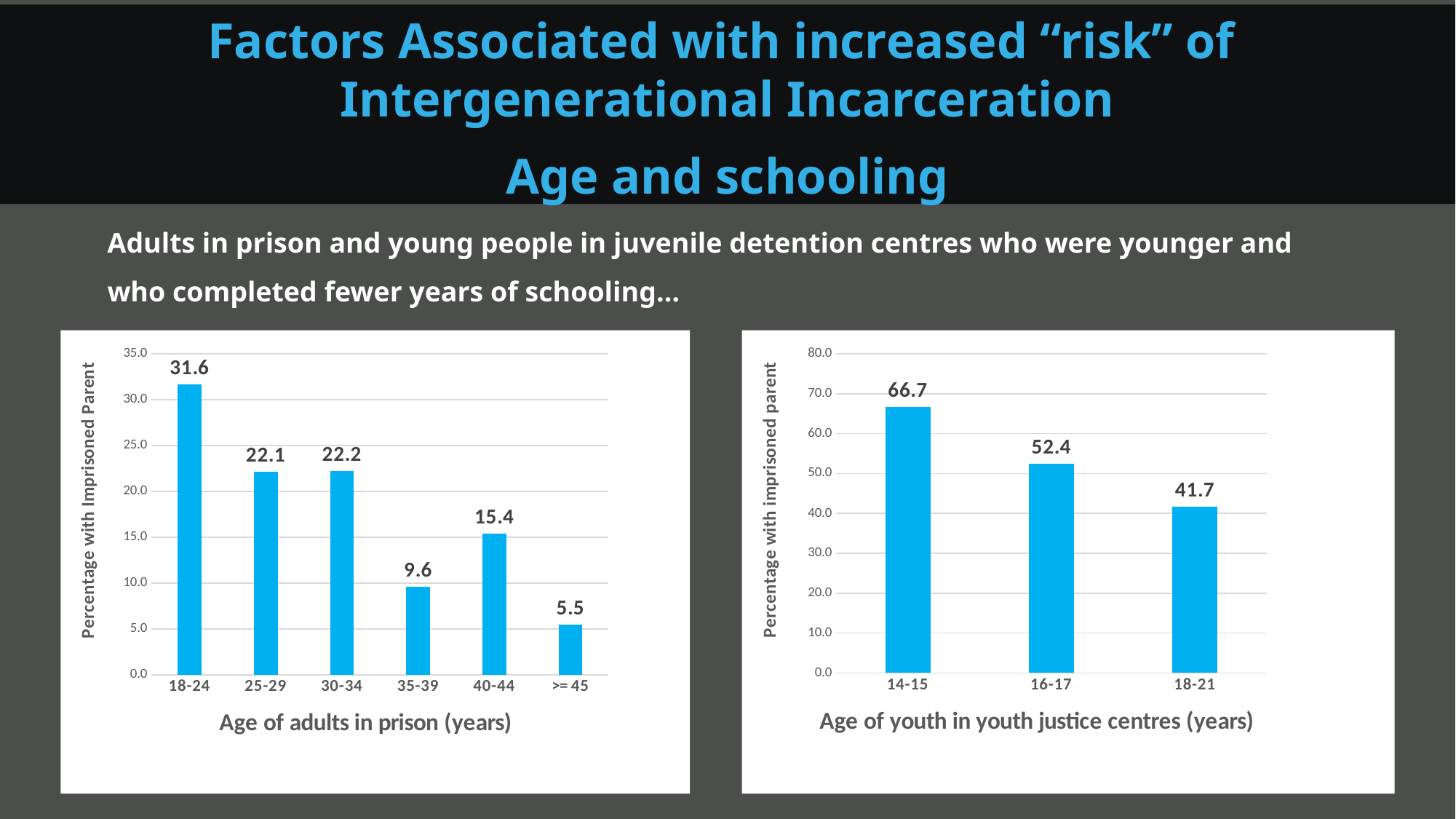
In the right chart (Age of youth in youth justice centres), what is the value for the 16-17 age group? 52.4 In the left chart (Age of adults in prison), what is the value for the 35-39 age group? 9.6 In the right chart (Age of youth in youth justice centres), what is the difference between the values for 14-15 and 18-21? 25.0 In the left chart (Age of adults in prison), what is the difference between the values for 18-24 and 40-44? 16.2 In the left chart (Age of adults in prison), what is the percentage with an imprisoned parent for the 18-24 age group? 31.6 In the right chart (Age of youth in youth justice centres), which age group has the highest percentage with an imprisoned parent? 14-15 What kind of chart is the right chart (Age of youth in youth justice centres)? bar chart In the right chart (Age of youth in youth justice centres), is the value for 18-21 greater or less than 40.0? greater In the left chart (Age of adults in prison), which age group has the lowest percentage with an imprisoned parent? >= 45 In the left chart (Age of adults in prison), how many age groups are shown on the x axis? 6 In the left chart (Age of adults in prison), which age group has the highest percentage with an imprisoned parent? 18-24 In the right chart (Age of youth in youth justice centres), do the values rise or fall as age increases along the x axis? fall